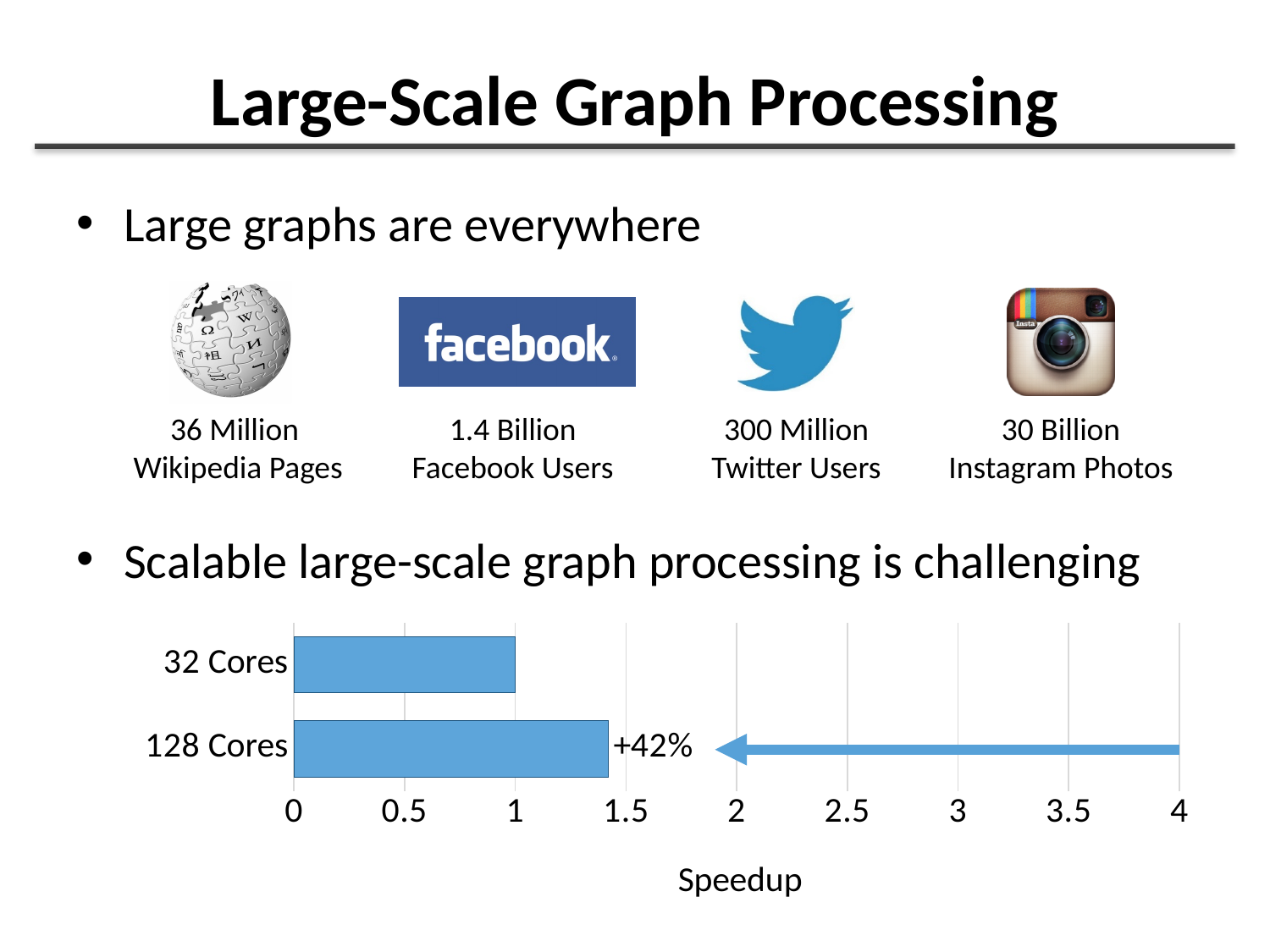
What is the title of the x axis in the bar chart? Speedup What annotation is printed next to the 128 Cores bar? +42% Is the speedup value for 128 Cores greater or less than 1.5? less What kind of chart is shown at the bottom of the slide? bar chart Which category has the lowest speedup in the bar chart? 32 Cores What is the speedup value for 32 Cores in the bar chart? 1 Which category has the highest speedup in the bar chart? 128 Cores Which has a larger speedup, 32 Cores or 128 Cores? 128 Cores Is the speedup value for 128 Cores greater or less than 1? greater Is the speedup value for 128 Cores greater or less than 2? less How many categories are plotted in the Speedup bar chart? 2